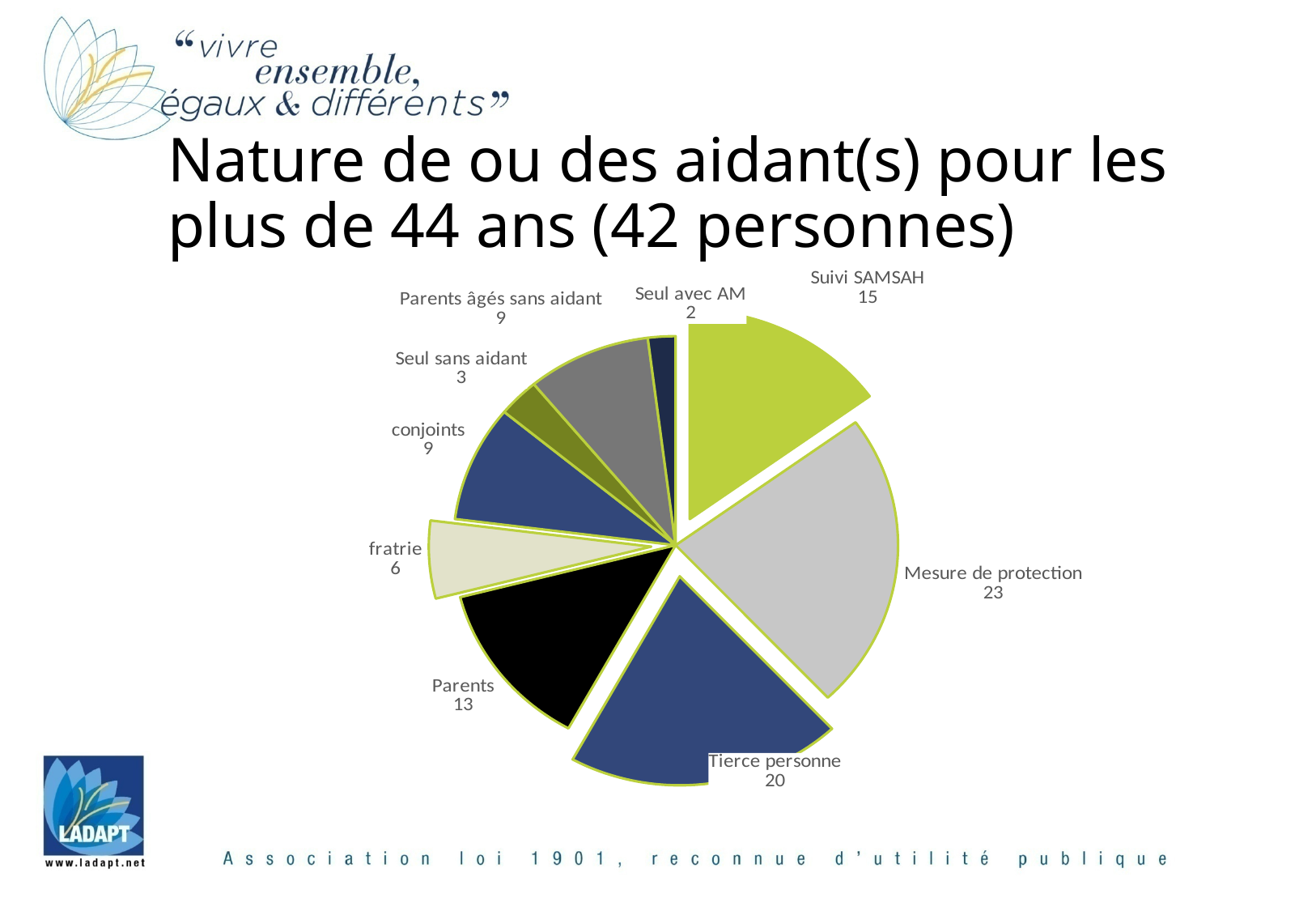
Which is larger, Tierce personne or Parents? Tierce personne What type of chart is shown on the slide? pie chart Which category has the largest slice? Mesure de protection What share of the pie does Suivi SAMSAH represent? 15% What is the difference between Parents and Seul sans aidant? 10 What is the value for fratrie? 6 What is the value for Mesure de protection? 23 Which category has the smallest slice? Seul avec AM What is the value for Tierce personne? 20 How many categories does the pie chart have? 9 What is the value for Parents âgés sans aidant? 9 What is the difference between Mesure de protection and Suivi SAMSAH? 8